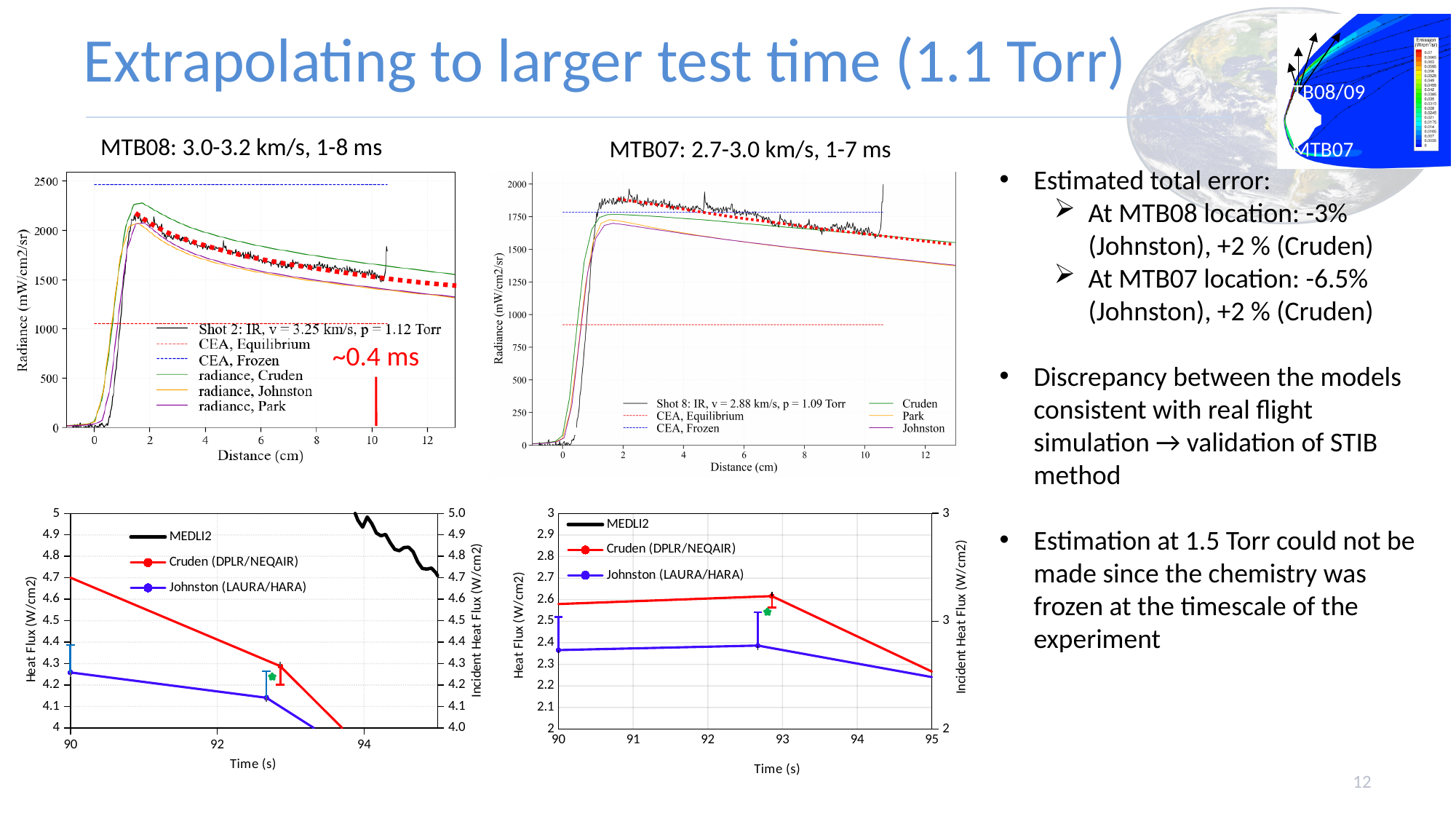
In the top-right radiance chart (MTB07), is the CEA, Equilibrium line greater or less than 1000 mW/cm2/sr? less In the bottom-left heat flux chart, which series has the larger value at 90 s, Cruden (DPLR/NEQAIR) or Johnston (LAURA/HARA)? Cruden (DPLR/NEQAIR) What kind of chart is the bottom-left chart (Heat Flux vs Time for MTB08)? line chart In the bottom-right heat flux chart (MTB07), is the Johnston (LAURA/HARA) value at 90 s greater or less than 2.5? less In the bottom-left heat flux chart, does the Cruden (DPLR/NEQAIR) line rise or fall as time increases? fall In the bottom-right heat flux chart (MTB07), is the Cruden (DPLR/NEQAIR) value at 90 s greater or less than 2.5? greater How many series does the legend of the bottom-left heat flux chart list? 3 What is the x-axis label of the bottom-right heat flux chart? Time (s) In the bottom-right heat flux chart (MTB07), which series has the larger value at 90 s, Cruden (DPLR/NEQAIR) or Johnston (LAURA/HARA)? Cruden (DPLR/NEQAIR)